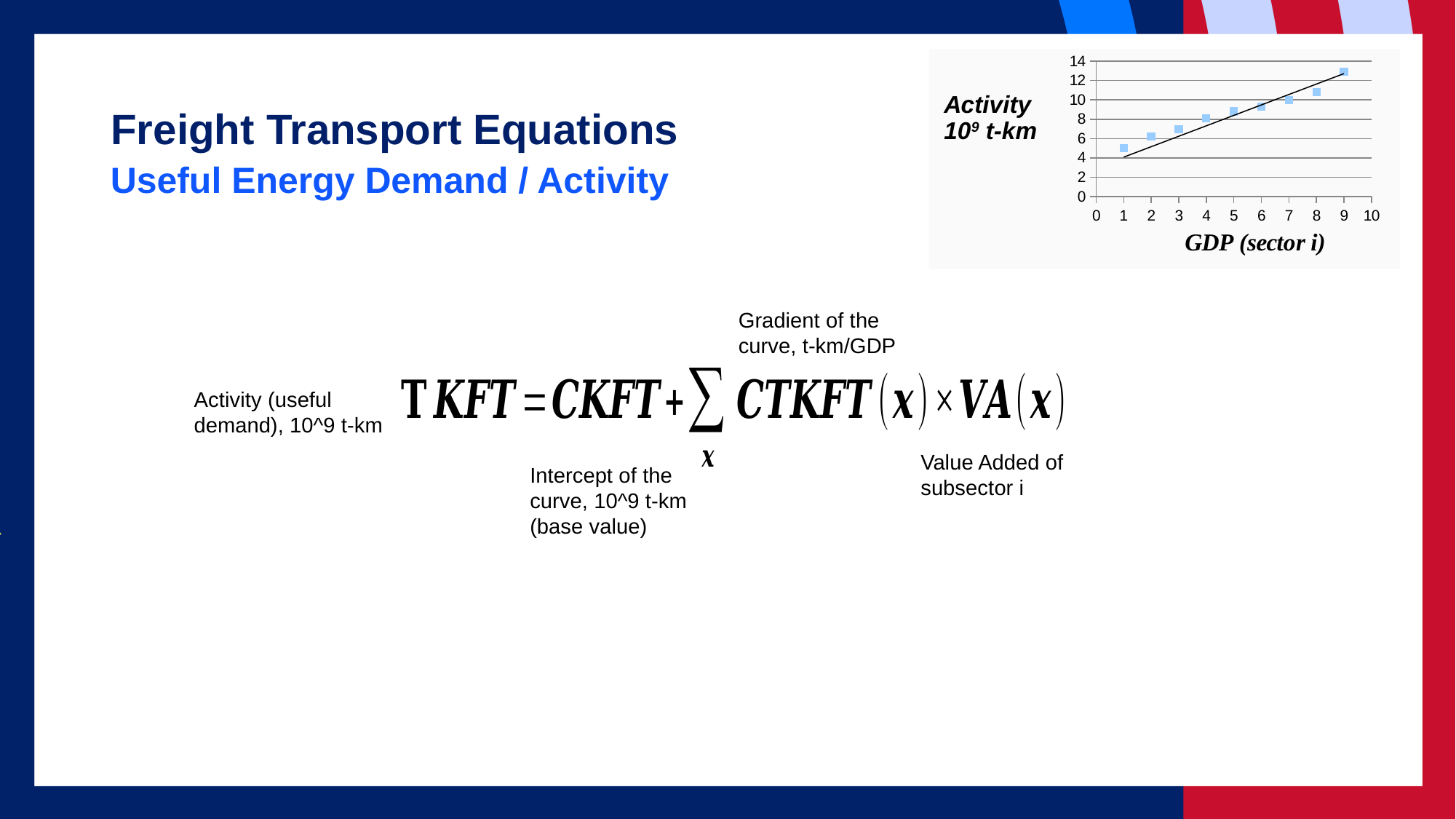
Is the Activity value at GDP 3 greater or less than 8? less Is the Activity value at GDP 5 greater or less than 8? greater Do the plotted values rise or fall as GDP increases along the x axis? rise Is the Activity value at GDP 9 greater or less than 12? greater How many data points are plotted in the chart? 9 What is the label of the y axis of the chart? Activity 10⁹ t-km What is the label of the x axis of the chart? GDP (sector i) What kind of chart is shown on the slide? scatter plot Which has the larger Activity value: GDP 2 or GDP 8? GDP 8 At which GDP value is the plotted Activity highest? 9 At which GDP value is the plotted Activity lowest? 1